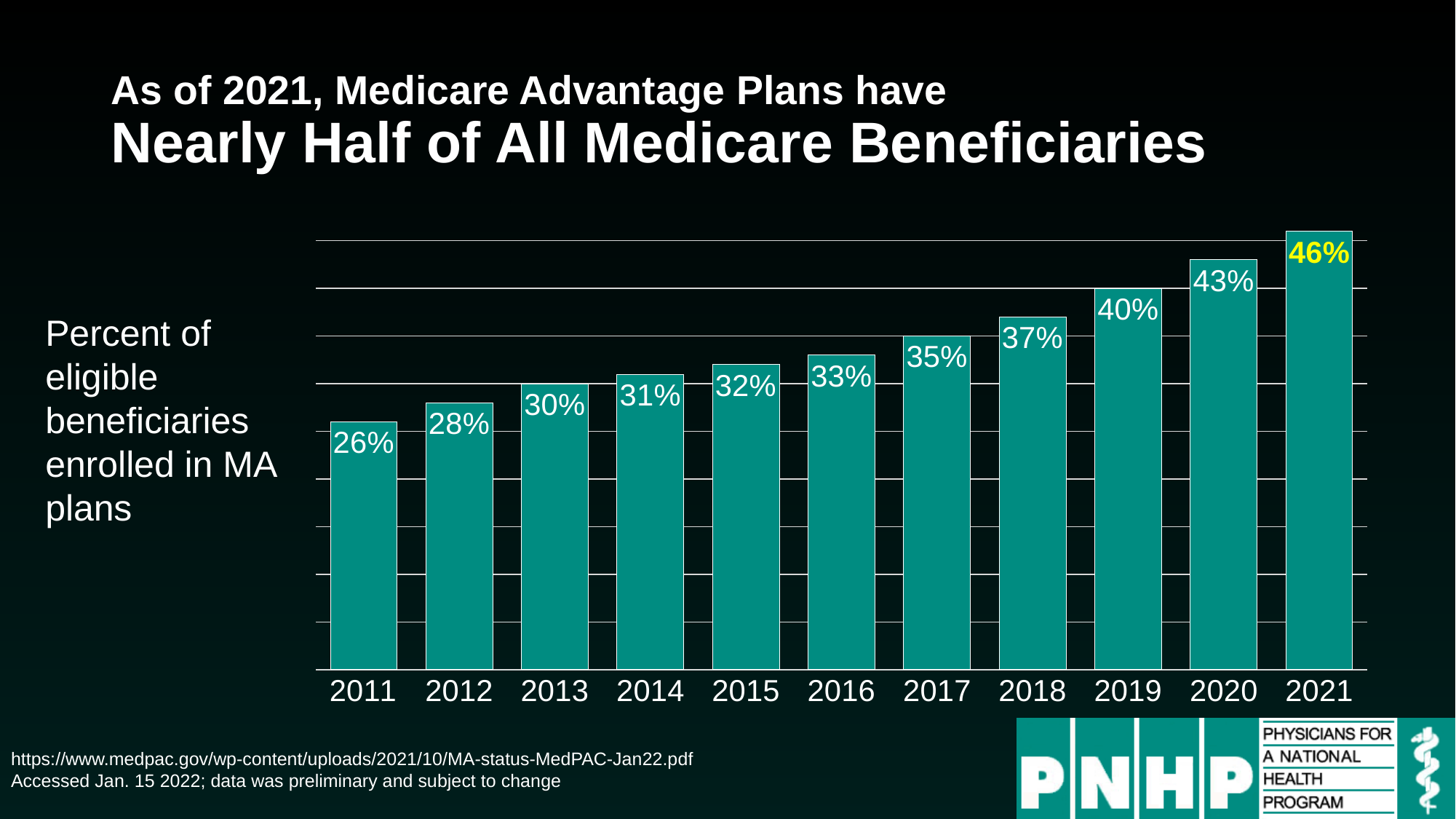
Do the values rise or fall from 2011 to 2021? Rise What is the difference in percentage points between 2020 and 2019? 3 What percent of eligible beneficiaries were enrolled in MA plans in 2021? 46% What is the difference in percentage points between the 2021 value and the 2011 value? 20 What percent of eligible beneficiaries were enrolled in MA plans in 2011? 26% What is the value shown for 2017? 35% How many years are shown on the x axis of the chart? 11 Which year has the lowest percent of eligible beneficiaries enrolled in MA plans? 2011 What kind of chart is shown on the slide? Bar chart Which year has a larger value, 2014 or 2018? 2018 Which data label on the chart is highlighted in yellow? 46% Which year has the highest percent of eligible beneficiaries enrolled in MA plans? 2021